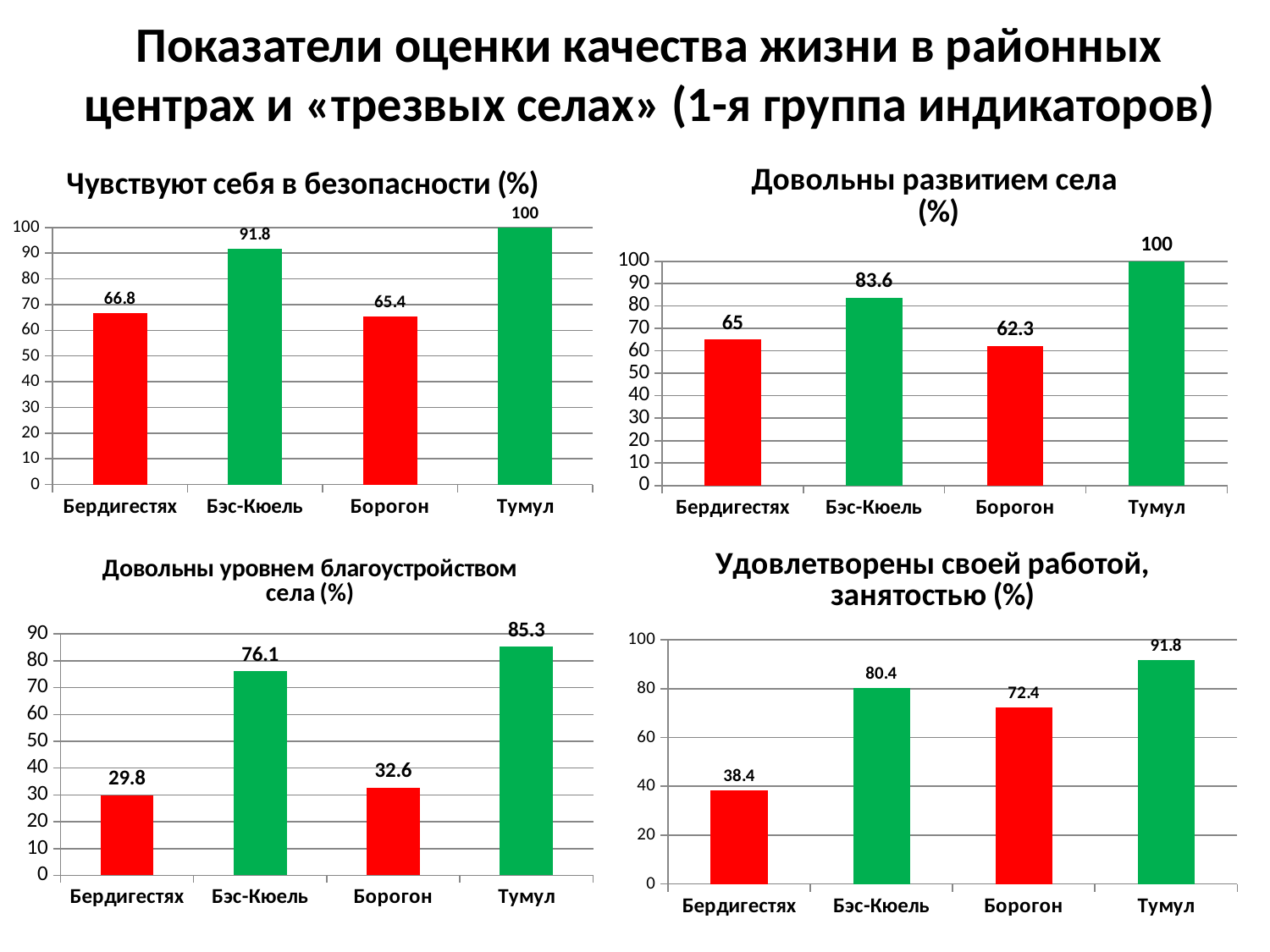
In the chart titled "Удовлетворены своей работой, занятостью (%)", what is the value for Борогон? 72.4 In the chart titled "Удовлетворены своей работой, занятостью (%)", which category has the lowest value? Бердигестях In the chart titled "Довольны уровнем благоустройством села (%)", what is the value for Бердигестях? 29.8 In the chart titled "Чувствуют себя в безопасности (%)", which category has the lowest value? Борогон In the chart titled "Чувствуют себя в безопасности (%)", what is the value for Бэс-Кюель? 91.8 In the chart titled "Довольны развитием села (%)", what is the value for Борогон? 62.3 What type of chart is the chart titled "Чувствуют себя в безопасности (%)"? Bar chart How many categories are shown in the chart titled "Удовлетворены своей работой, занятостью (%)"? 4 In the chart titled "Довольны развитием села (%)", which category has the highest value? Тумул In the chart titled "Довольны уровнем благоустройством села (%)", what is the difference between the values for Тумул and Бэс-Кюель? 9.2 In the chart titled "Довольны уровнем благоустройством села (%)", which is larger, the value for Борогон or the value for Бердигестях? Борогон In the chart titled "Довольны развитием села (%)", what is the difference between the values for Бэс-Кюель and Бердигестях? 18.6